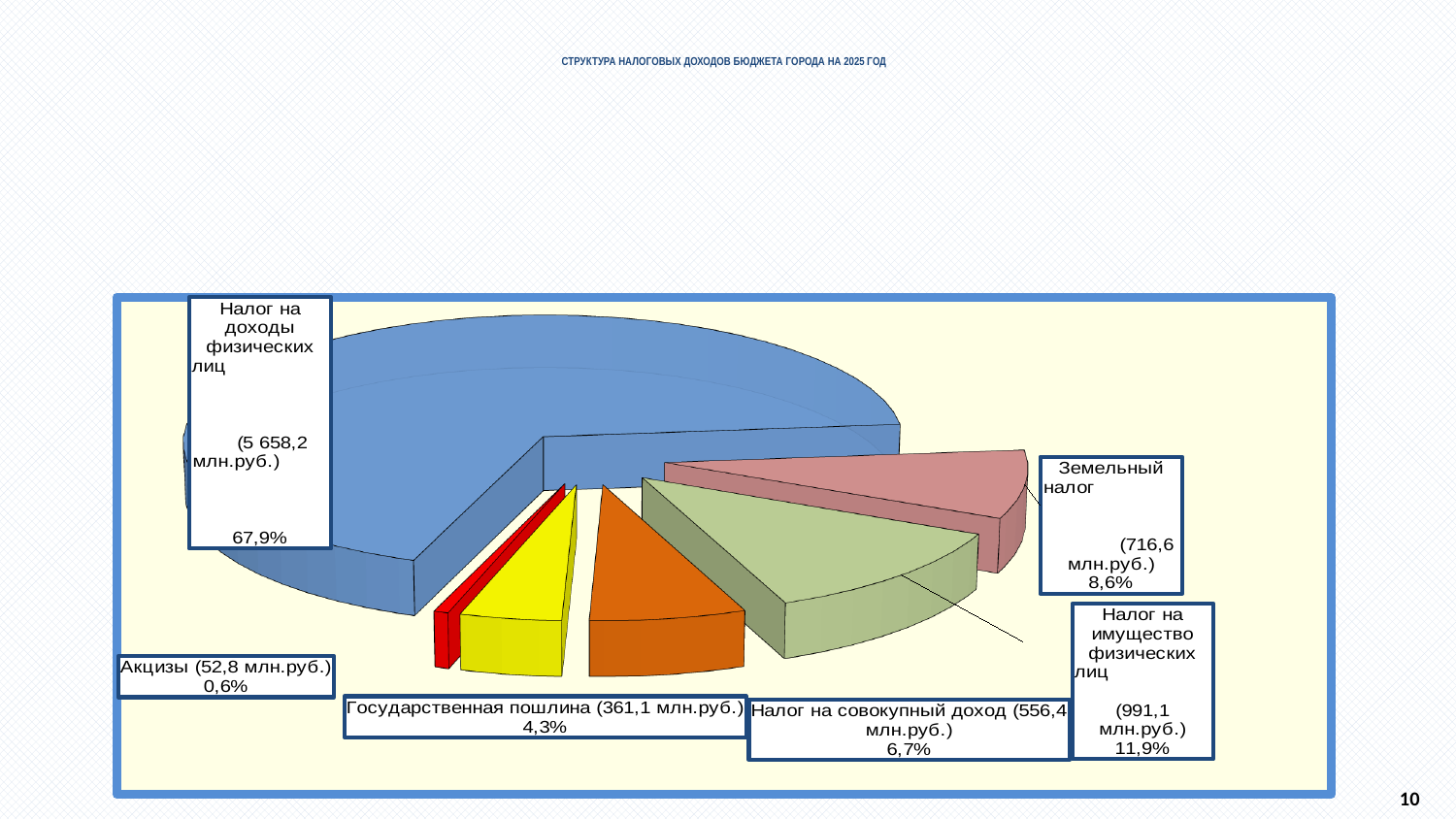
Which slice of the pie is the smallest? Акцизы Which is larger: "Земельный налог" or "Налог на совокупный доход"? Земельный налог What percentage is shown for "Налог на имущество физических лиц"? 11,9% How many slices does the pie chart have? 6 What is the value shown for "Акцизы"? 52,8 млн.руб. Which slice of the pie is the largest? Налог на доходы физических лиц What kind of chart is shown on the slide? pie chart What percentage is shown for "Государственная пошлина"? 4,3% What is the value shown for "Земельный налог"? 716,6 млн.руб. What is the title of the chart on the slide? СТРУКТУРА НАЛОГОВЫХ ДОХОДОВ БЮДЖЕТА ГОРОДА НА 2025 ГОД What is the difference in percentage points between "Налог на имущество физических лиц" (11,9%) and "Земельный налог" (8,6%)? 3,3% What share of the pie does "Налог на доходы физических лиц" represent? 67,9%